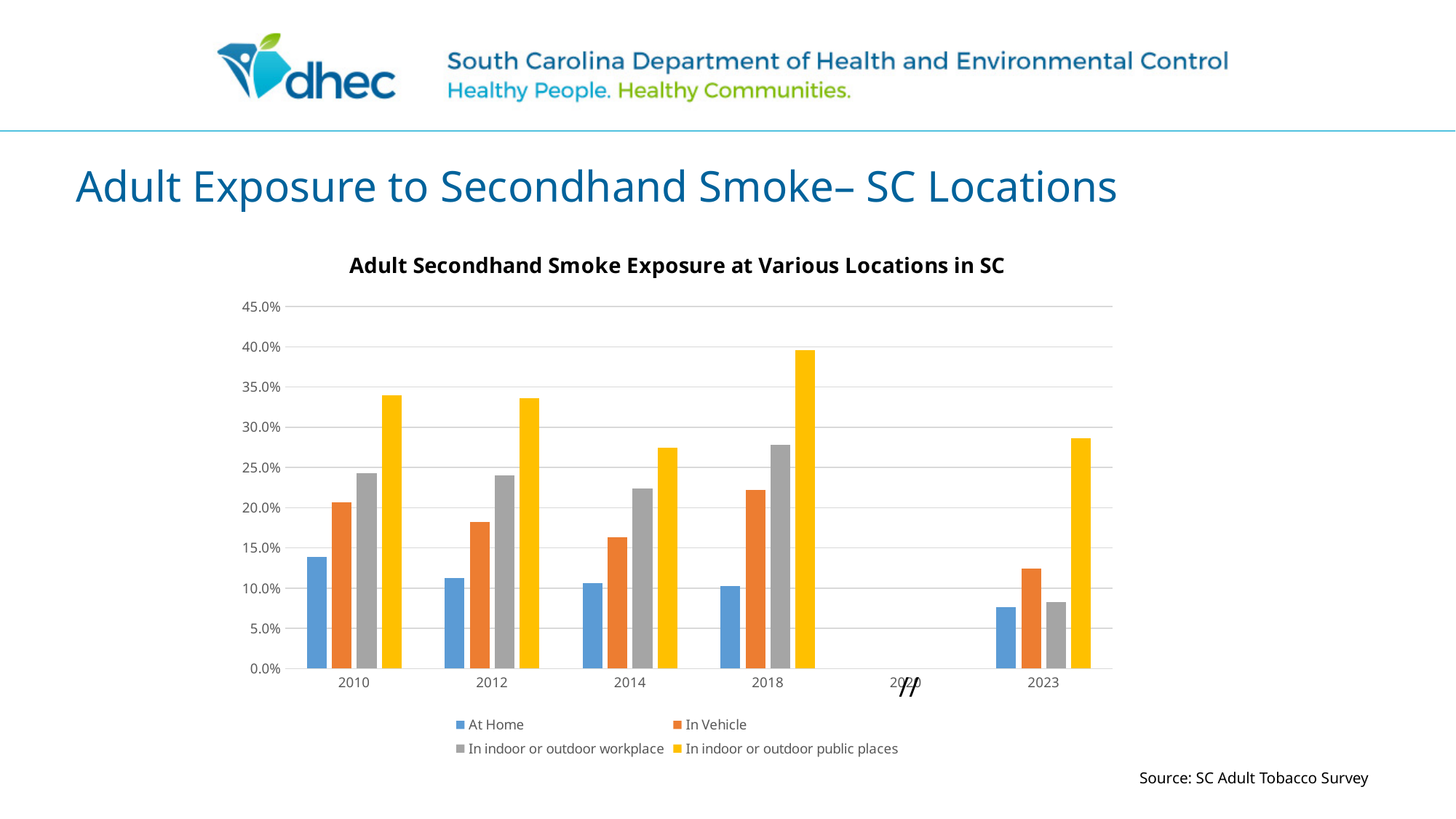
Which series has the highest bar in 2018? In indoor or outdoor public places In 2023, which is larger: 'In Vehicle' or 'In indoor or outdoor workplace'? In Vehicle What kind of chart is shown on the slide? Bar chart Is the value for 'At Home' in 2023 greater or less than 10.0%? less Does the 'At Home' series rise or fall from 2010 to 2023? Fall Is the value for 'In indoor or outdoor public places' in 2018 greater or less than 35.0%? greater Is the value for 'In indoor or outdoor workplace' in 2014 greater or less than 20.0%? greater In 2010, which is larger: 'In Vehicle' or 'In indoor or outdoor workplace'? In indoor or outdoor workplace How many series does the legend list? 4 Which series has the lowest bar in 2023? At Home In which year is the 'In indoor or outdoor public places' bar the tallest? 2018